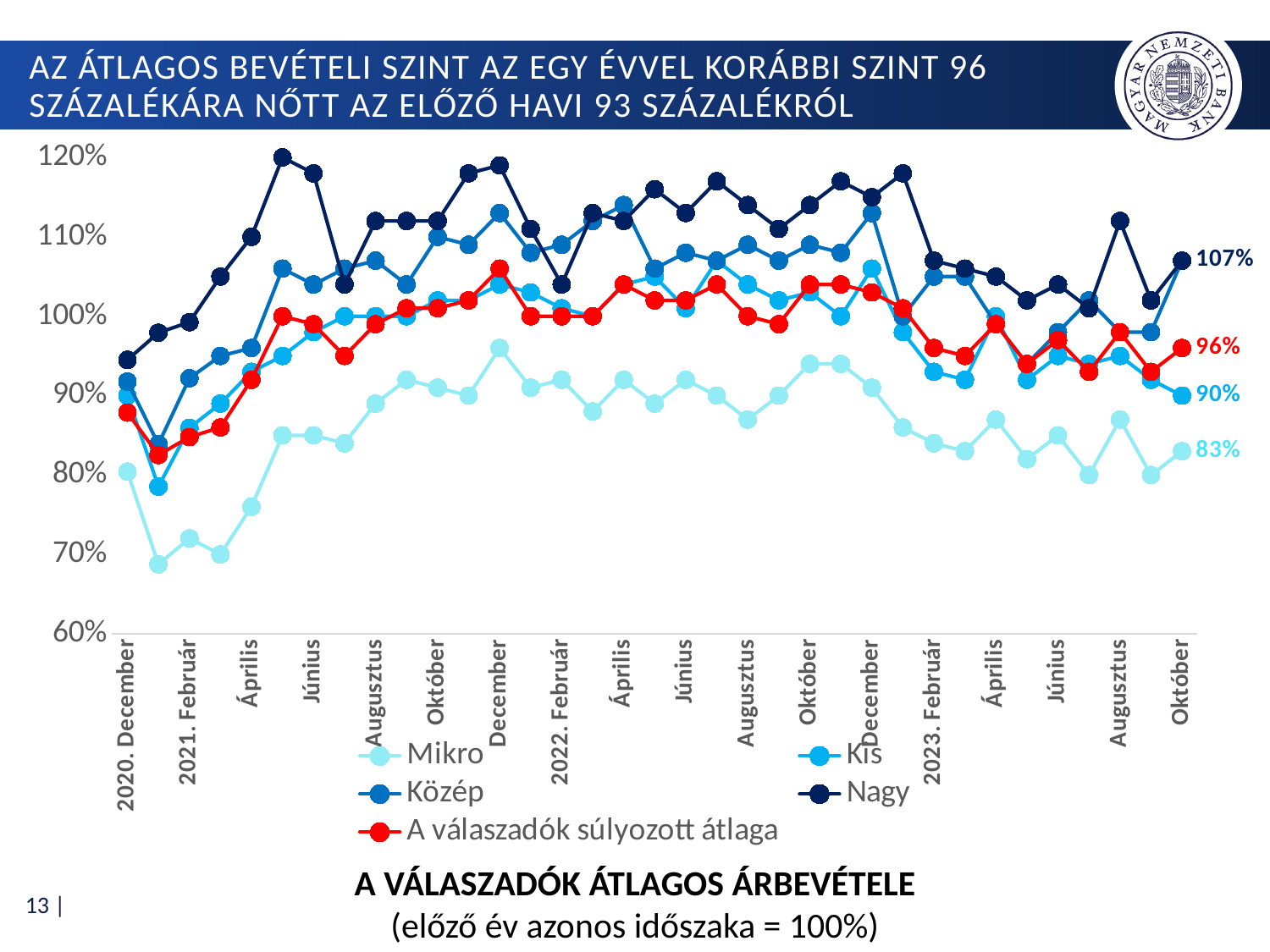
What type of chart is shown on the slide? line chart Which series has the lowest value at 2023 Október? Mikro What is the value of the Mikro series at 2023 Október? 83% What is the title printed below the chart? A VÁLASZADÓK ÁTLAGOS ÁRBEVÉTELE Does the Nagy series rise or fall from 2020 December to 2021 Április? rise At 2023 Október, what is the difference between the Nagy value and the Mikro value? 24 percentage points How many series does the legend list? 5 What is the value of the Nagy series at 2023 Október? 107% What is the value of 'A válaszadók súlyozott átlaga' at 2023 Október? 96% Is the value for Mikro at 2021 Április greater or less than 80%? less What is the value of the Kis series at 2023 Október? 90% At 2023 Október, which is larger: the Kis value or the Mikro value? Kis